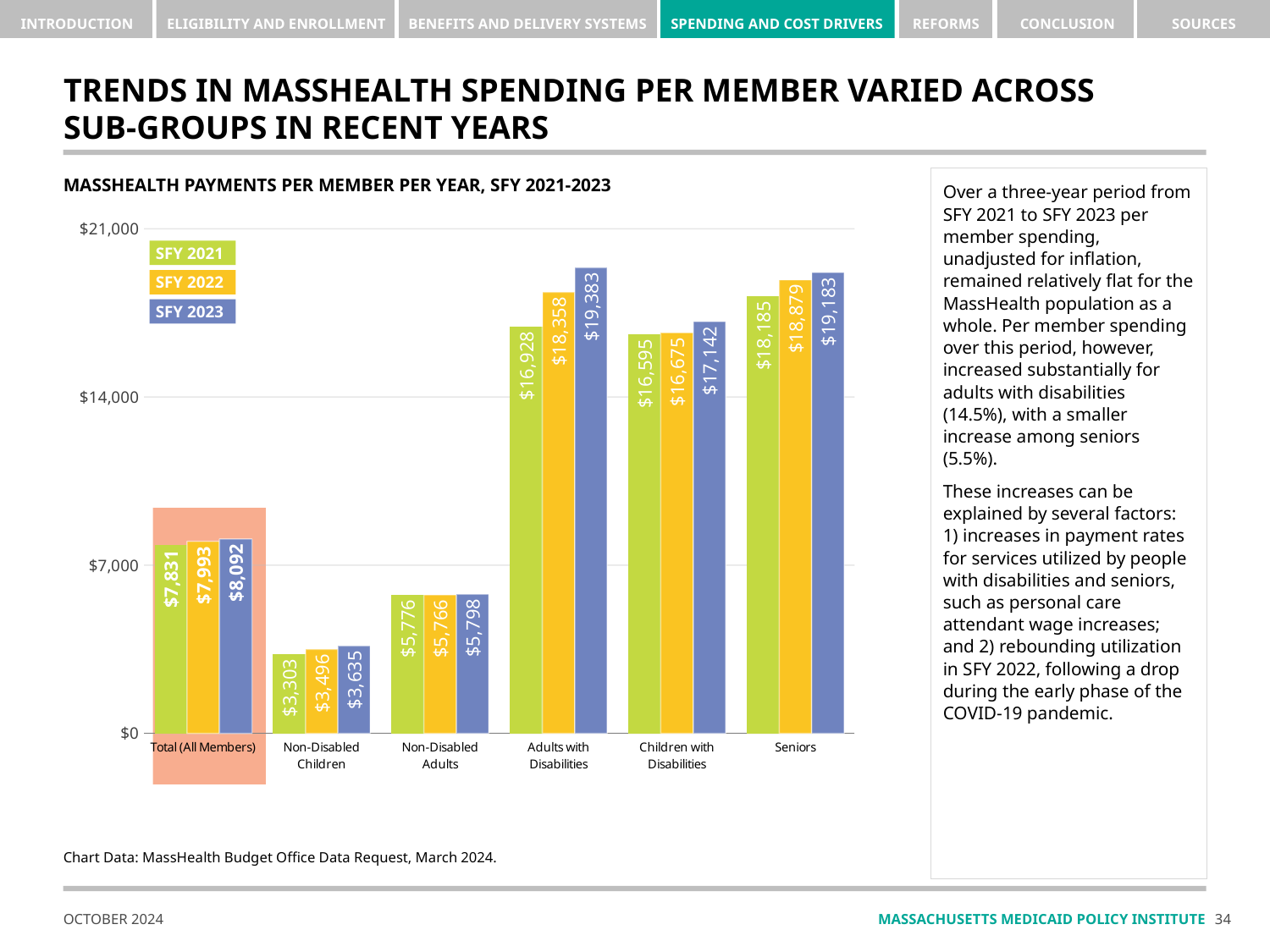
What is the difference between the SFY 2023 and SFY 2021 payments per member for Adults with Disabilities? $2,455 How many series does the legend list? 3 What was the payment per member per year for Non-Disabled Children in SFY 2021? $3,303 How many member categories are shown on the x axis? 6 What was the MassHealth payment per member per year for Adults with Disabilities in SFY 2023? $19,383 What type of chart is shown on the slide? Bar chart What is the title of the chart? MassHealth Payments Per Member Per Year, SFY 2021-2023 What was the payment per member per year for Seniors in SFY 2022? $18,879 Which category had the highest payment per member per year in SFY 2021? Seniors Which was larger in SFY 2023: the payment per member for Adults with Disabilities or for Seniors? Adults with Disabilities Which category had the lowest payment per member per year in SFY 2023? Non-Disabled Children Did the payment per member per year for Total (All Members) rise or fall from SFY 2021 to SFY 2023? Rise